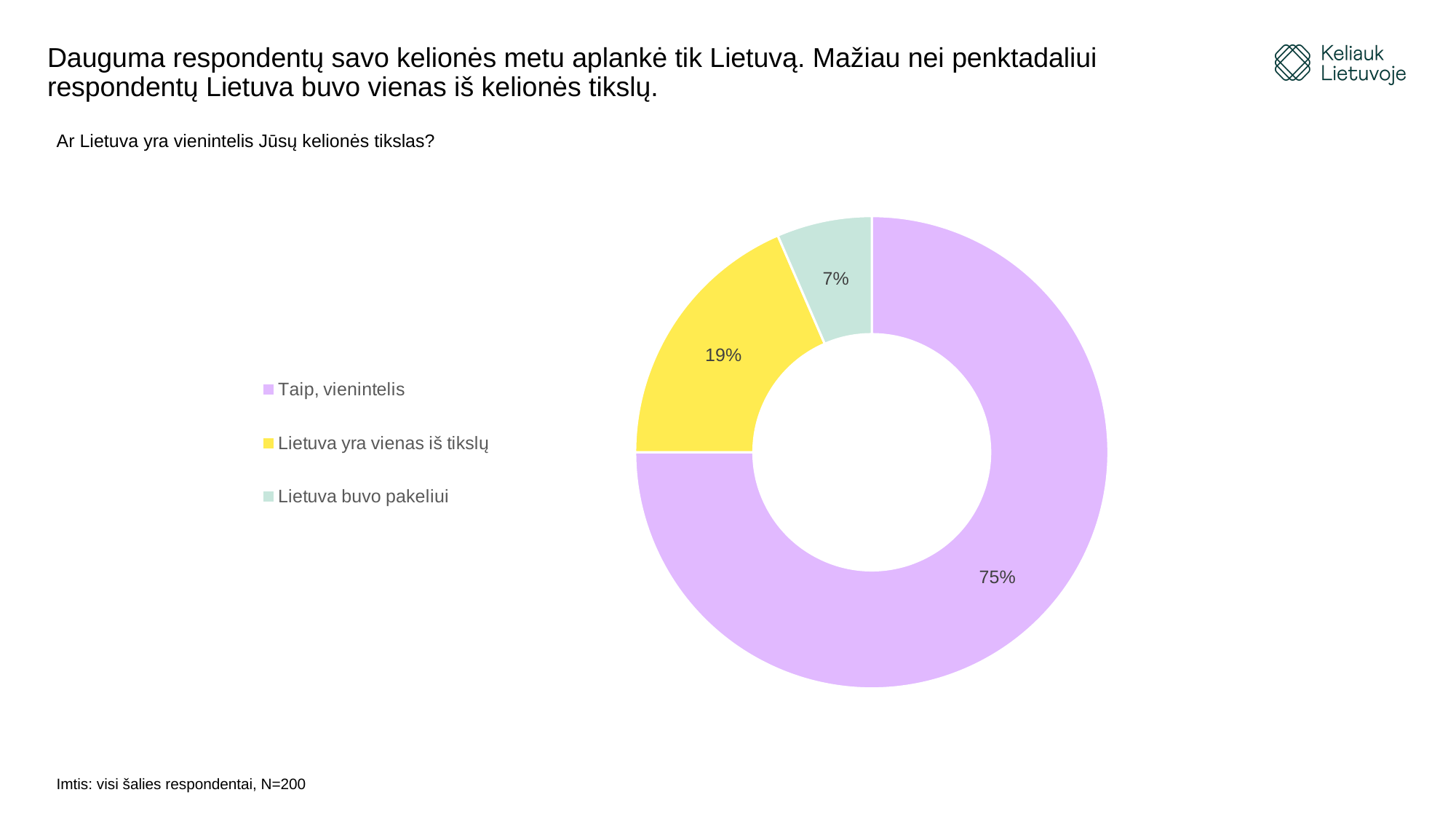
Which is larger: the share for "Lietuva yra vienas iš tikslų" or for "Lietuva buvo pakeliui"? Lietuva yra vienas iš tikslų How many categories does the pie chart show? 3 What share of respondents answered "Taip, vienintelis"? 75% What is the difference in percentage points between "Taip, vienintelis" and "Lietuva yra vienas iš tikslų"? 56 percentage points What is the sample size stated at the bottom of the slide? N=200 What share of respondents answered "Lietuva yra vienas iš tikslų"? 19% Which category has the smallest share of the pie? Lietuva buvo pakeliui What share of respondents answered "Lietuva buvo pakeliui"? 7% What kind of chart is shown on the slide? Pie chart (doughnut) Which category has the largest share of the pie? Taip, vienintelis What is the difference in percentage points between "Lietuva yra vienas iš tikslų" and "Lietuva buvo pakeliui"? 12 percentage points What question does the chart answer, as written above it? Ar Lietuva yra vienintelis Jūsų kelionės tikslas?